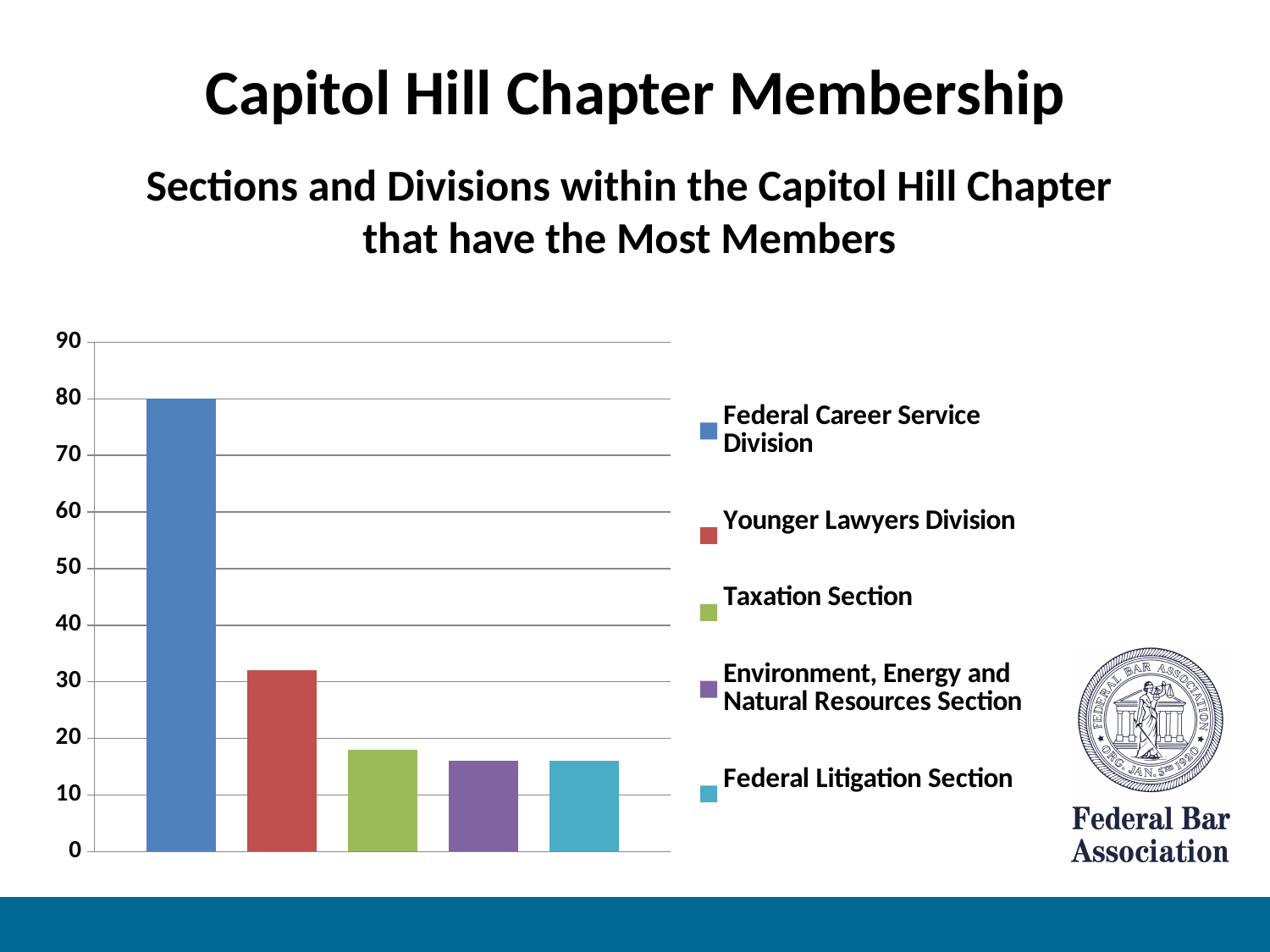
Which section or division has the highest number of members in the chart? Federal Career Service Division What is the title of the chart on the slide? Sections and Divisions within the Capitol Hill Chapter that have the Most Members Is the value for the Younger Lawyers Division greater or less than 40? less What type of chart is shown on the slide? Bar chart How many entries does the chart's legend list? 5 Is the value for the Federal Litigation Section greater or less than 10? greater What is the value for the Federal Career Service Division? 80 Which has more members, the Federal Career Service Division or the Younger Lawyers Division? Federal Career Service Division How many bars are plotted in the chart? 5 Do the bar values rise or fall from left to right across the chart? Fall Which has more members, the Younger Lawyers Division or the Taxation Section? Younger Lawyers Division Is the value for the Taxation Section greater or less than 20? less